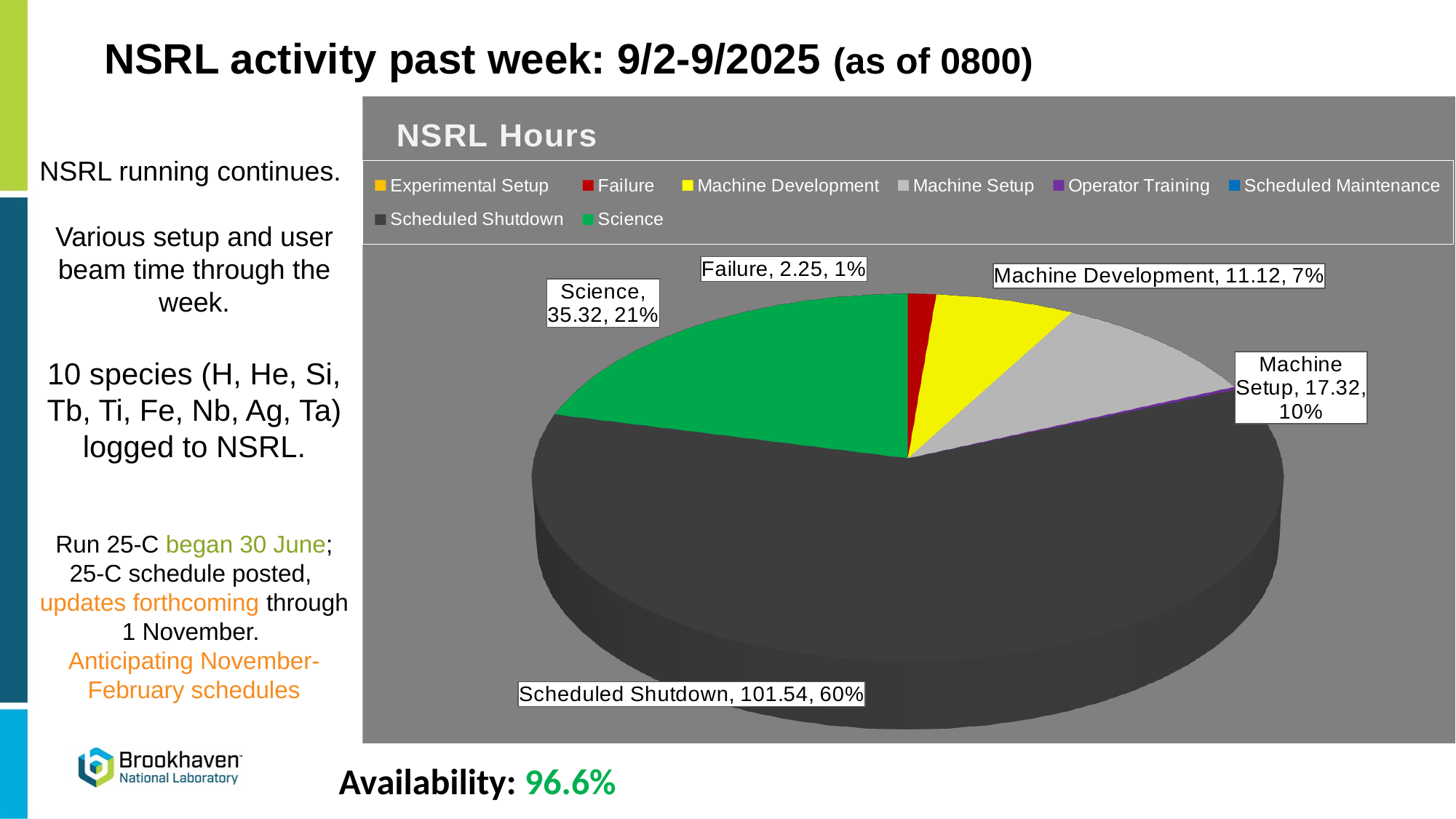
How many entries does the chart legend list? 8 Which labelled category has the largest slice of the pie? Scheduled Shutdown How many hours are labelled for Machine Setup? 17.32 How many hours are labelled for Failure? 2.25 What is the title of the chart? NSRL Hours How many hours are labelled for Scheduled Shutdown? 101.54 What is the difference in hours between Science and Machine Setup? 18.00 What type of chart is shown on the slide? pie chart How many hours are labelled for Science? 35.32 Which is larger, Machine Development or Machine Setup? Machine Setup What share of the pie does Scheduled Shutdown represent? 60% Which labelled category has the smallest slice of the pie? Failure